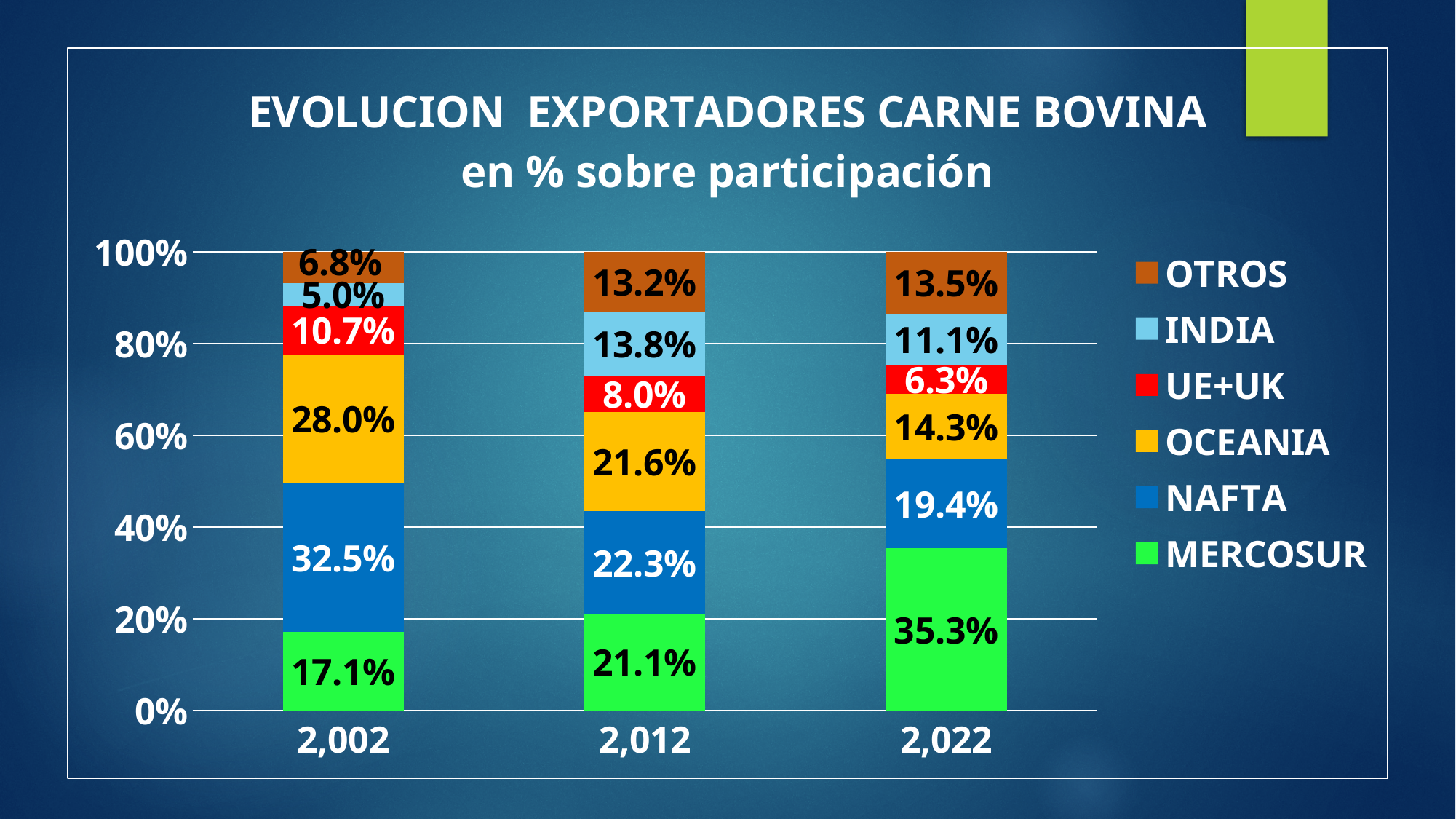
By how many percentage points did the MERCOSUR share increase from 2,002 to 2,022? 18.2% How many years are shown on the x axis? 3 How many series does the legend list? 6 What is the NAFTA share in 2,002? 32.5% What is the OCEANIA share in 2,012? 21.6% Which series has the smallest share in 2,002? INDIA What kind of chart is shown on the slide? Stacked bar chart Which series has the largest share in 2,002? NAFTA In 2,012, which is larger: the INDIA share or the OTROS share? INDIA Does the OCEANIA share rise or fall from 2,002 to 2,022? Fall What is the UE+UK share in 2,022? 6.3% What is the MERCOSUR share in 2,022? 35.3%